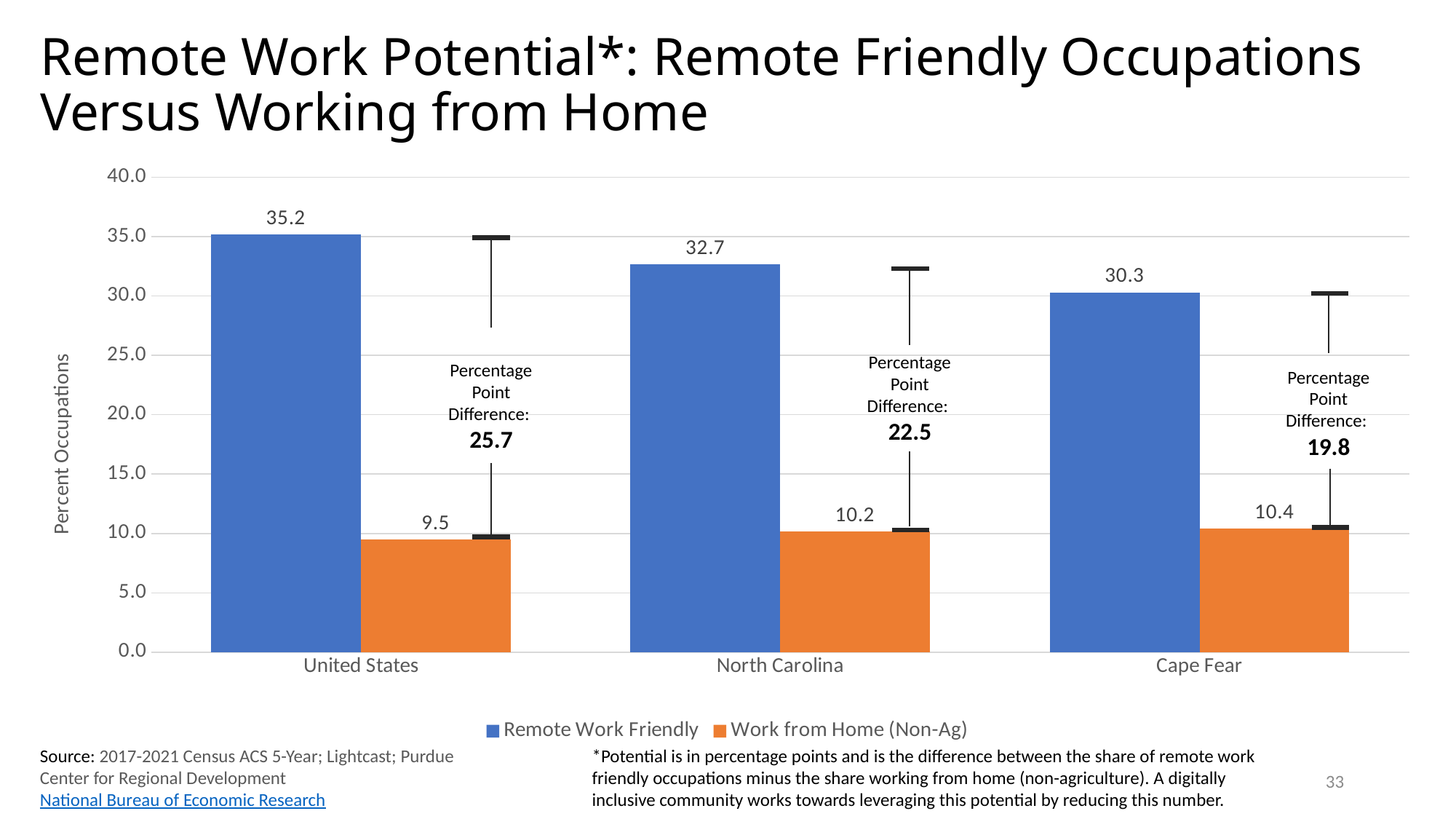
Which is larger, the Remote Work Friendly value for Cape Fear or for North Carolina? North Carolina Which category has the lowest Work from Home (Non-Ag) value? United States How many categories are shown on the x axis? 3 Which category has the highest Remote Work Friendly value? United States What is the Work from Home (Non-Ag) value for Cape Fear? 10.4 How many series does the legend list? 2 Is the Remote Work Friendly value for Cape Fear greater or less than 35.0? less What is the difference between the Remote Work Friendly and Work from Home (Non-Ag) values for North Carolina? 22.5 What is the label of the y axis? Percent Occupations What is the Remote Work Friendly value for North Carolina? 32.7 What kind of chart is shown on the slide? bar chart What is the Remote Work Friendly value for the United States? 35.2